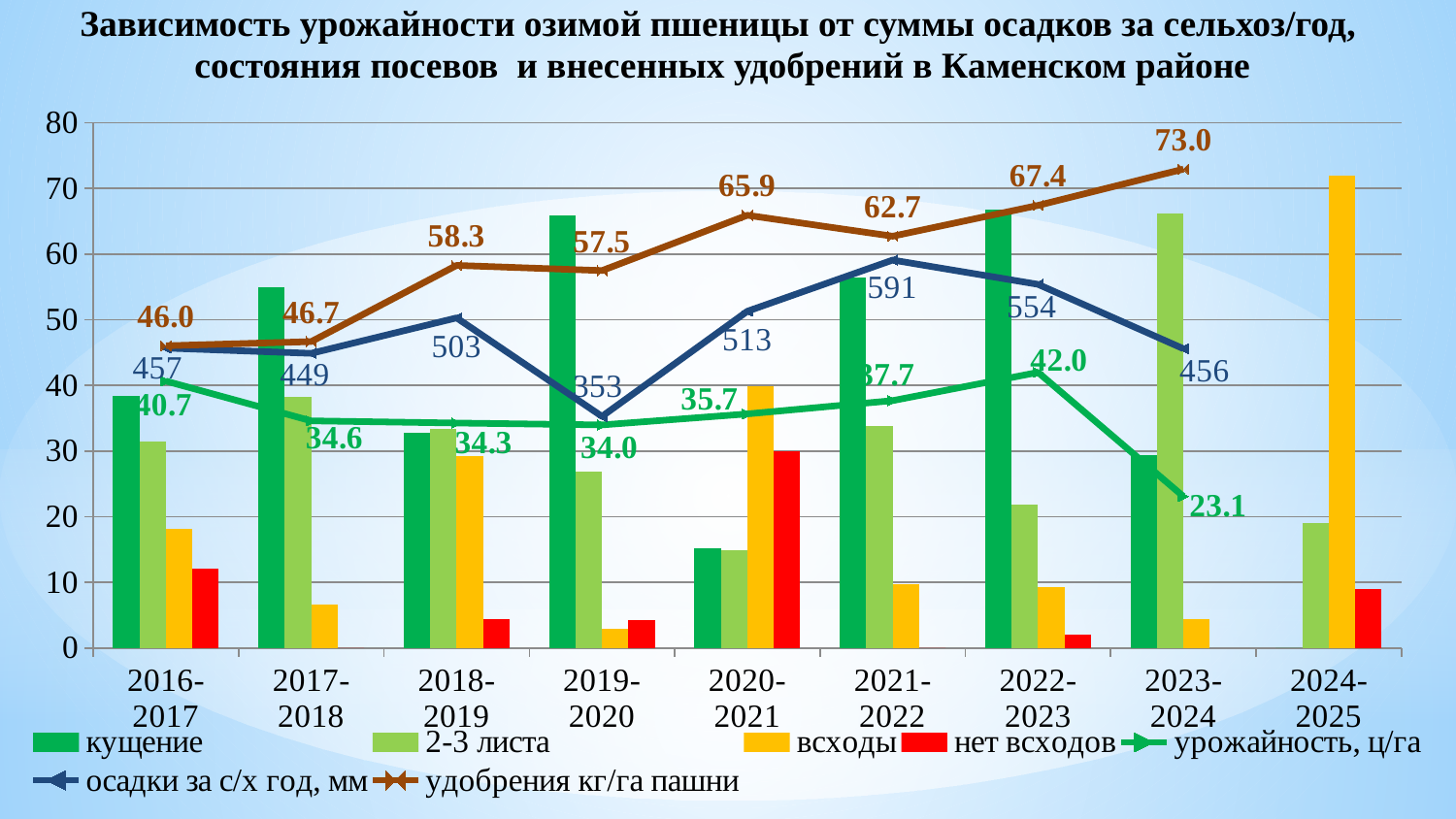
In which year is the урожайность, ц/га value the lowest? 2023-2024 What is the осадки за с/х год, мм value for 2021-2022? 591 In which year is the осадки за с/х год, мм value the highest? 2021-2022 What is the осадки за с/х год, мм value for 2019-2020? 353 What kind of chart is this? Combined bar and line chart What is the удобрения кг/га пашни value for 2023-2024? 73.0 Is the кущение bar for 2019-2020 greater or less than 60? greater What is the урожайность, ц/га value for 2022-2023? 42.0 How many series does the legend list? 7 How many year categories are shown on the x axis? 9 What is the difference between the удобрения кг/га пашни values for 2023-2024 and 2016-2017? 27.0 Which year has the larger осадки за с/х год, мм value: 2018-2019 or 2020-2021? 2020-2021